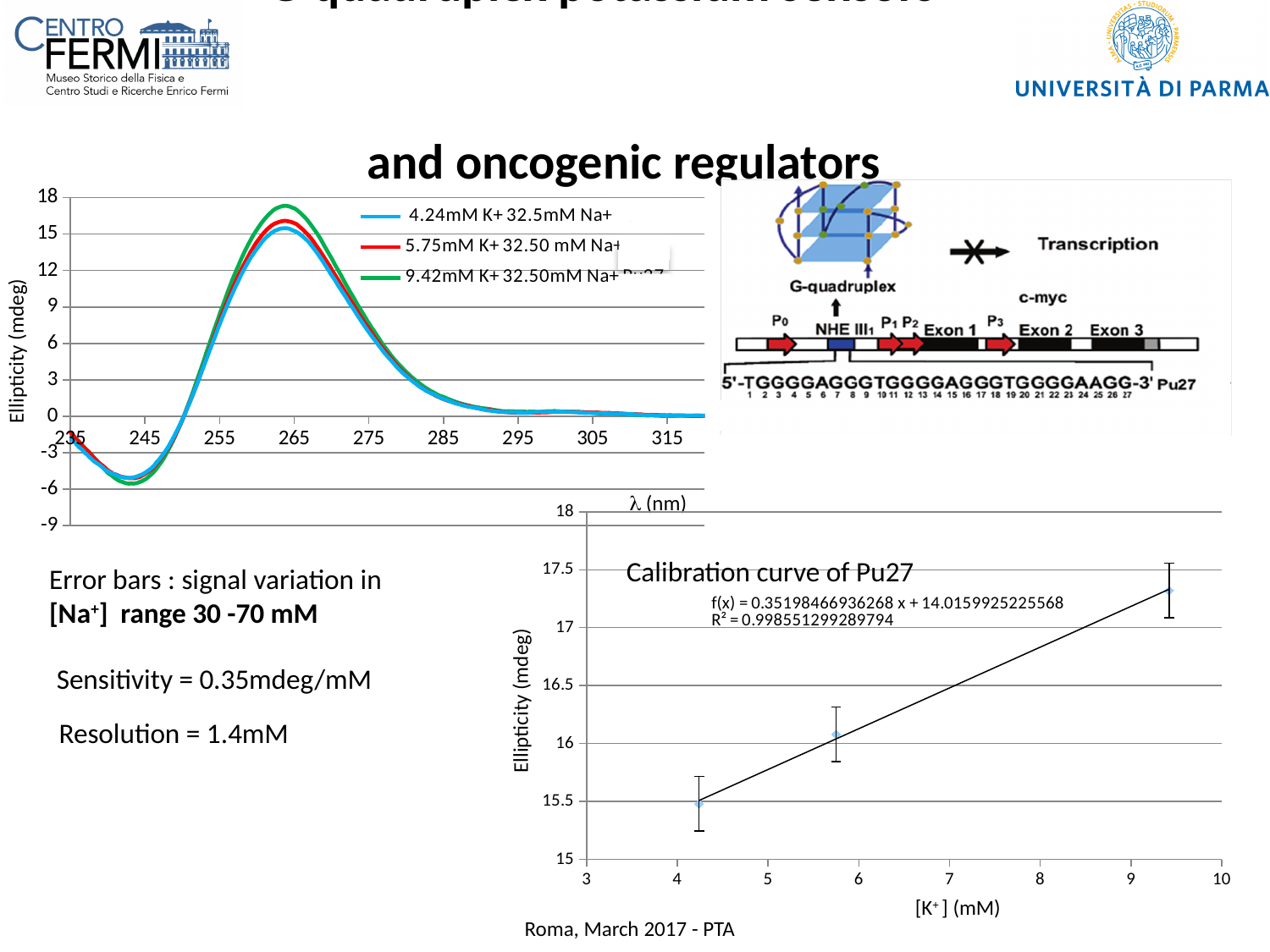
In the Calibration curve of Pu27 chart, do the ellipticity values rise or fall as [K+] increases? rise In the Calibration curve of Pu27 chart, what R² value is printed for the fitted line? 0.998551299289794 How many series does the legend of the top-left ellipticity chart list? 3 In the top-left ellipticity chart, is the peak value of the 9.42mM K+ 32.50mM Na+ series greater or less than 15? greater In the Calibration curve of Pu27 chart, is the ellipticity of the point at the lowest [K+] greater or less than 16? less How many data points are plotted in the Calibration curve of Pu27 chart? 3 In the top-left ellipticity chart, which series reaches the highest peak value? 9.42mM K+ 32.50mM Na+ What is the title of the bottom-right chart? Calibration curve of Pu27 In the Calibration curve of Pu27 chart, is the ellipticity of the point at the highest [K+] greater or less than 17? greater In the top-left ellipticity chart, what colour is the line for the 4.24mM K+ 32.5mM Na+ series? blue What kind of chart is the top-left chart showing ellipticity versus wavelength? line chart